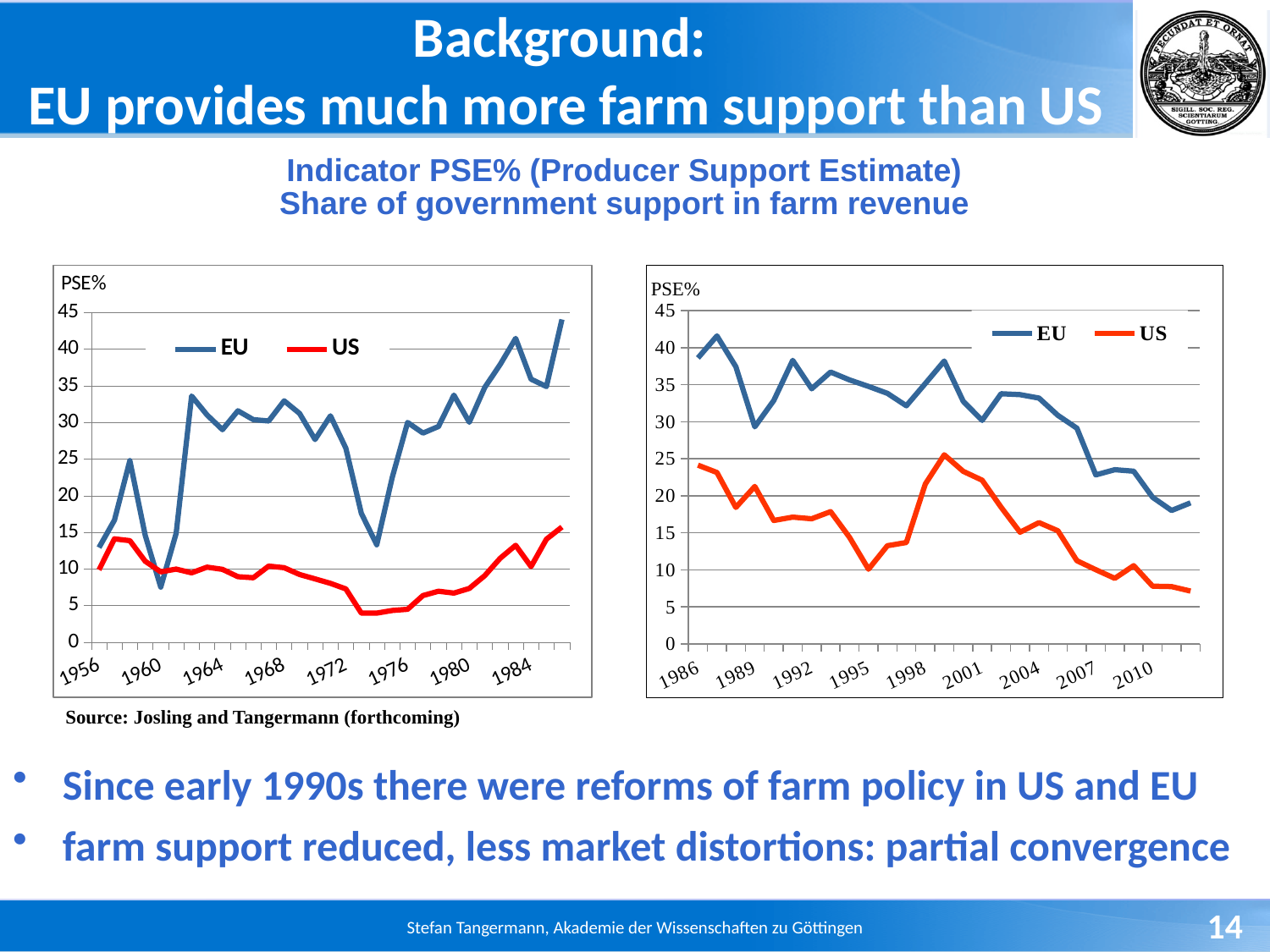
In the right chart, is the US value for 2011 greater or less than 10? less In the right chart, is the EU value for 1987 greater or less than 40? greater In the left chart, which series has the higher value in 1984, EU or US? EU How many series does the legend of the right chart (1986–2012) list? 2 In the right chart, which series has the higher value in 1986, EU or US? EU In the right chart, which colour is used for the US series? red In the right chart, does the US series generally rise or fall from 1986 to 2012? fall In the left chart, is the EU value for 1986 greater or less than 40? greater What kind of chart is the left chart (1956–1986)? line chart